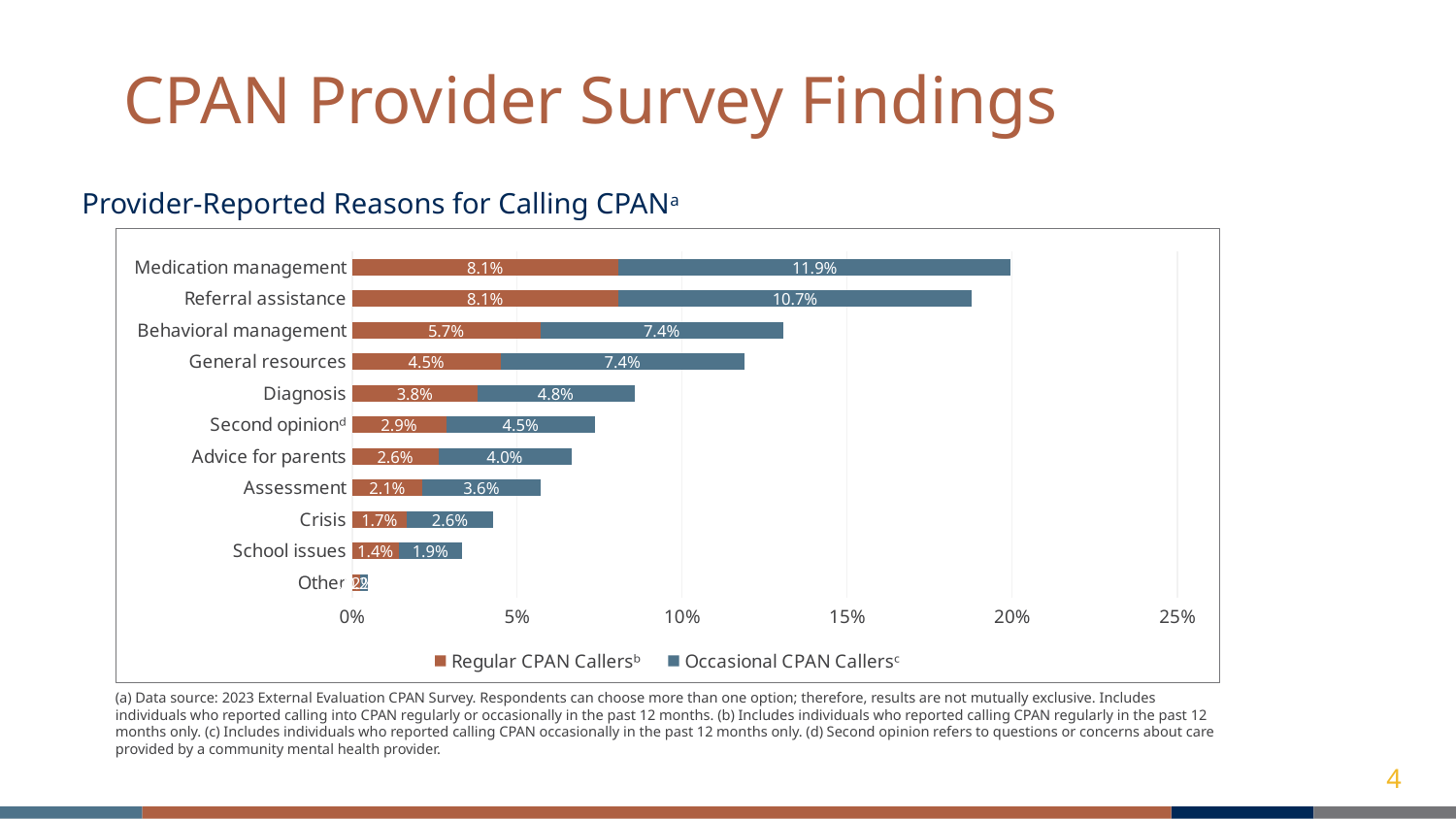
What is the difference between the Occasional CPAN Callers values for Medication management and Referral assistance? 1.2% What kind of chart is shown on the slide? Stacked bar chart What is the total of the stacked bar for Referral assistance? 18.8% Which reason has the highest value for Occasional CPAN Callers? Medication management How many series does the legend list? 2 Which is larger: the Regular CPAN Callers value for Diagnosis or for Second opinion? Diagnosis What is the value for Regular CPAN Callers for Behavioral management? 5.7% How many reasons for calling CPAN are listed on the chart? 11 Which series is shown in orange in the legend? Regular CPAN Callers What is the value for Occasional CPAN Callers for Medication management? 11.9% Which reason has the lowest value for Regular CPAN Callers among those with readable labels? School issues What is the value for Occasional CPAN Callers for Assessment? 3.6%